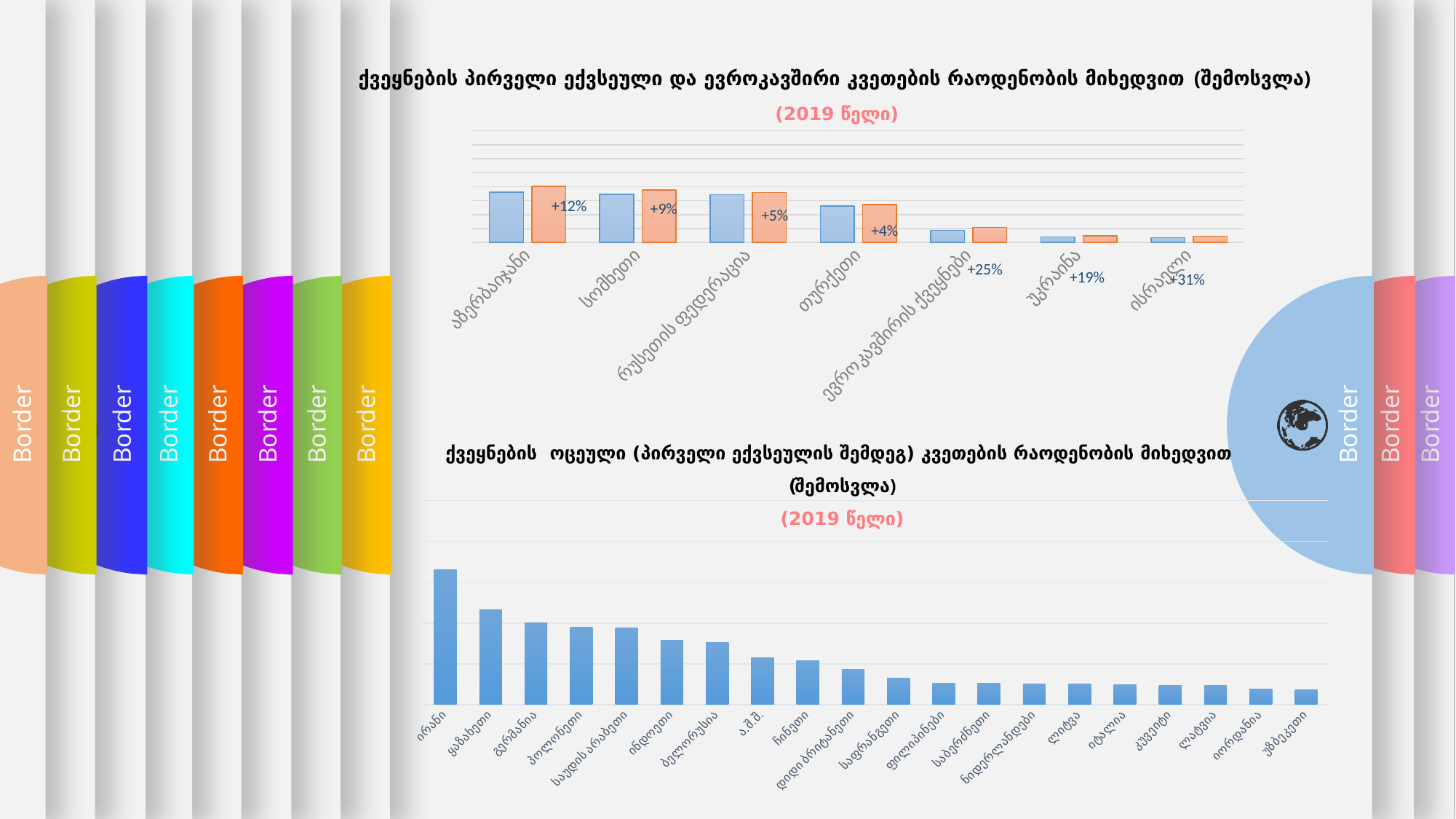
In the bottom chart, which country has the highest bar? ირანი In the top chart, what percentage change is labelled for ისრაელი? +31% In the top chart, how many categories are shown on the x axis? 7 In the bottom chart, do the bars generally rise or fall from left to right? Fall In the top chart, which category has the largest labelled percentage change? ისრაელი In the top chart, what percentage change is labelled for ევროკავშირის ქვეყნები? +25% In the top chart, what percentage change is labelled for სომხეთი? +9% In the bottom chart, how many countries are shown on the x axis? 20 In the top chart, which category has the smallest labelled percentage change? თურქეთი In the top chart, which has taller bars, აზერბაიჯანი or უკრაინა? აზერბაიჯანი What kind of chart is the bottom chart? Bar chart In the top chart, what percentage change is labelled for აზერბაიჯანი? +12%